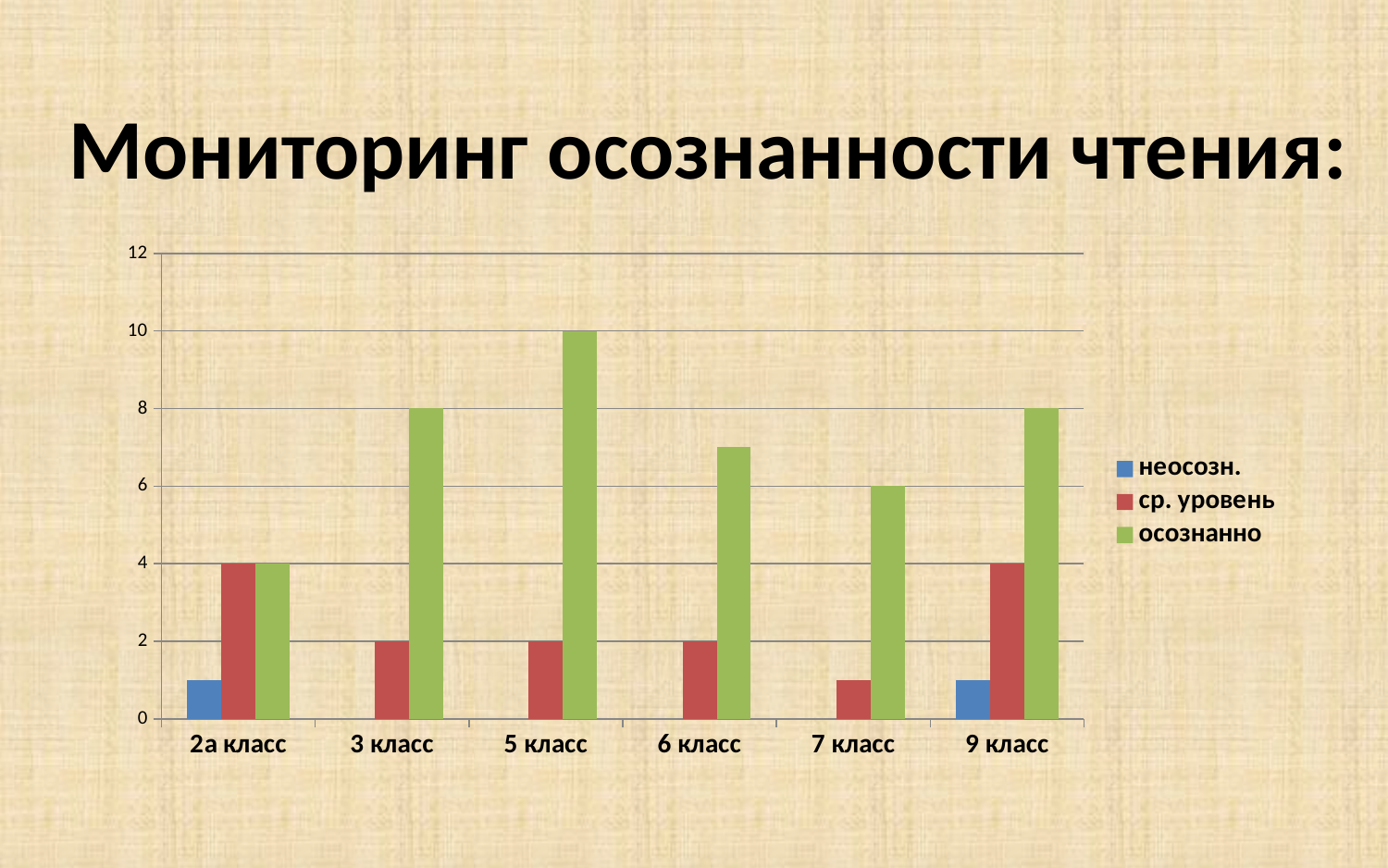
Which class has the lowest value for 'осознанно'? 2а класс What type of chart is shown on the slide? bar chart How many series does the legend list? 3 What is the value of 'ср. уровень' for 9 класс? 4 What is the value of 'осознанно' for 5 класс? 10 What is the title of the chart on the slide? Мониторинг осознанности чтения: What is the value of 'осознанно' for 3 класс? 8 Is the 'осознанно' value for 6 класс greater or less than 8? less How many classes (categories) are shown on the x axis? 6 What is the difference between the 'осознанно' values for 5 класс and 9 класс? 2 Which is larger: the 'ср. уровень' value for 2а класс or for 3 класс? 2а класс Which class has the highest value for 'осознанно'? 5 класс